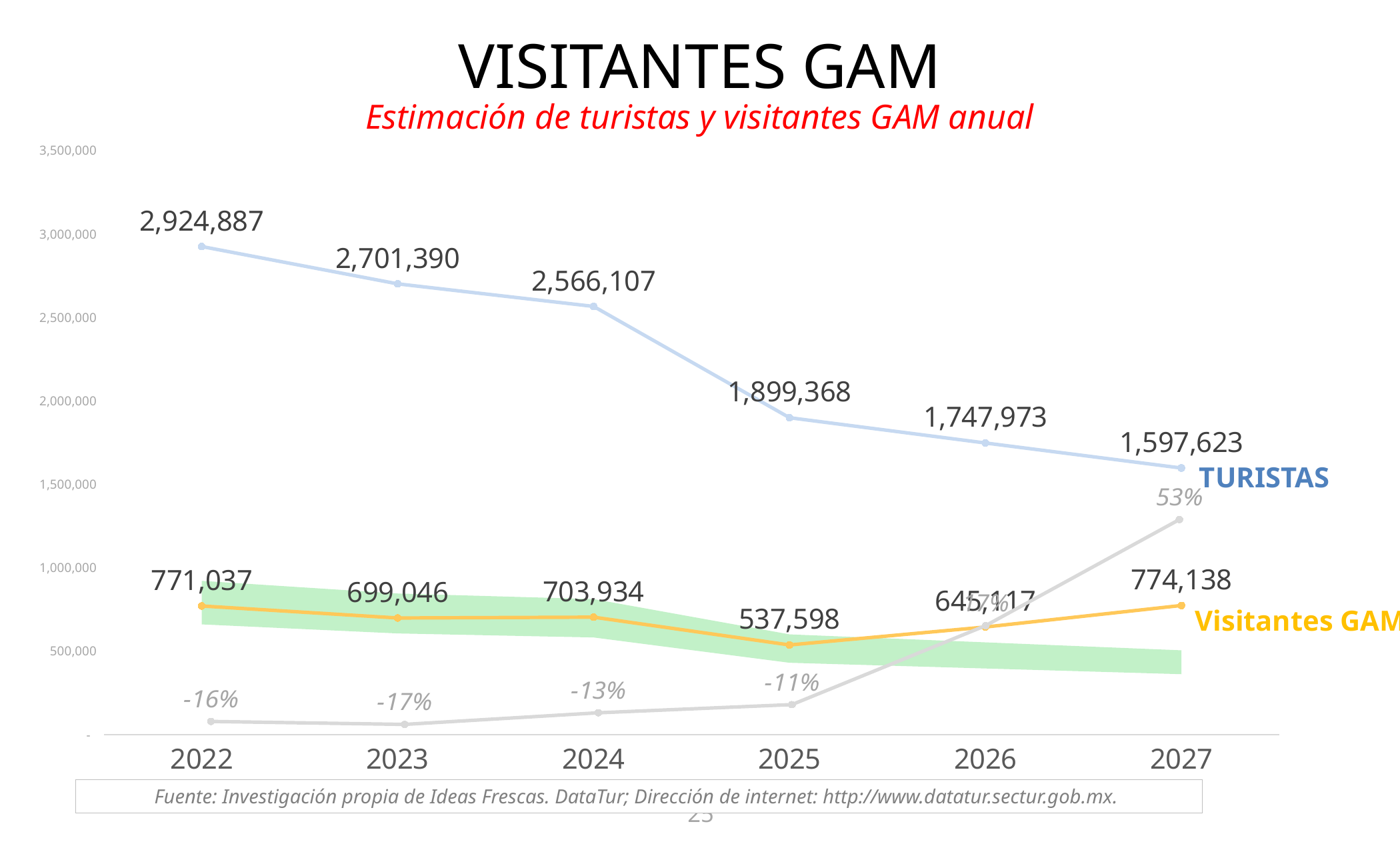
What is the difference between the Visitantes GAM values for 2027 and 2025? 236,540 What is the difference between the TURISTAS values for 2022 and 2027? 1,327,264 What is the TURISTAS value for 2027? 1,597,623 What is the Visitantes GAM value for 2025? 537,598 In which year is the TURISTAS value lowest? 2027 Does the TURISTAS series rise or fall from 2022 to 2027? fall Which is larger, the TURISTAS value for 2025 or the TURISTAS value for 2024? 2024 What kind of chart is shown on the slide? line chart What is the Visitantes GAM value for 2027? 774,138 How many years are shown on the x axis? 6 In which year is the Visitantes GAM value lowest? 2025 What is the TURISTAS value for 2022? 2,924,887